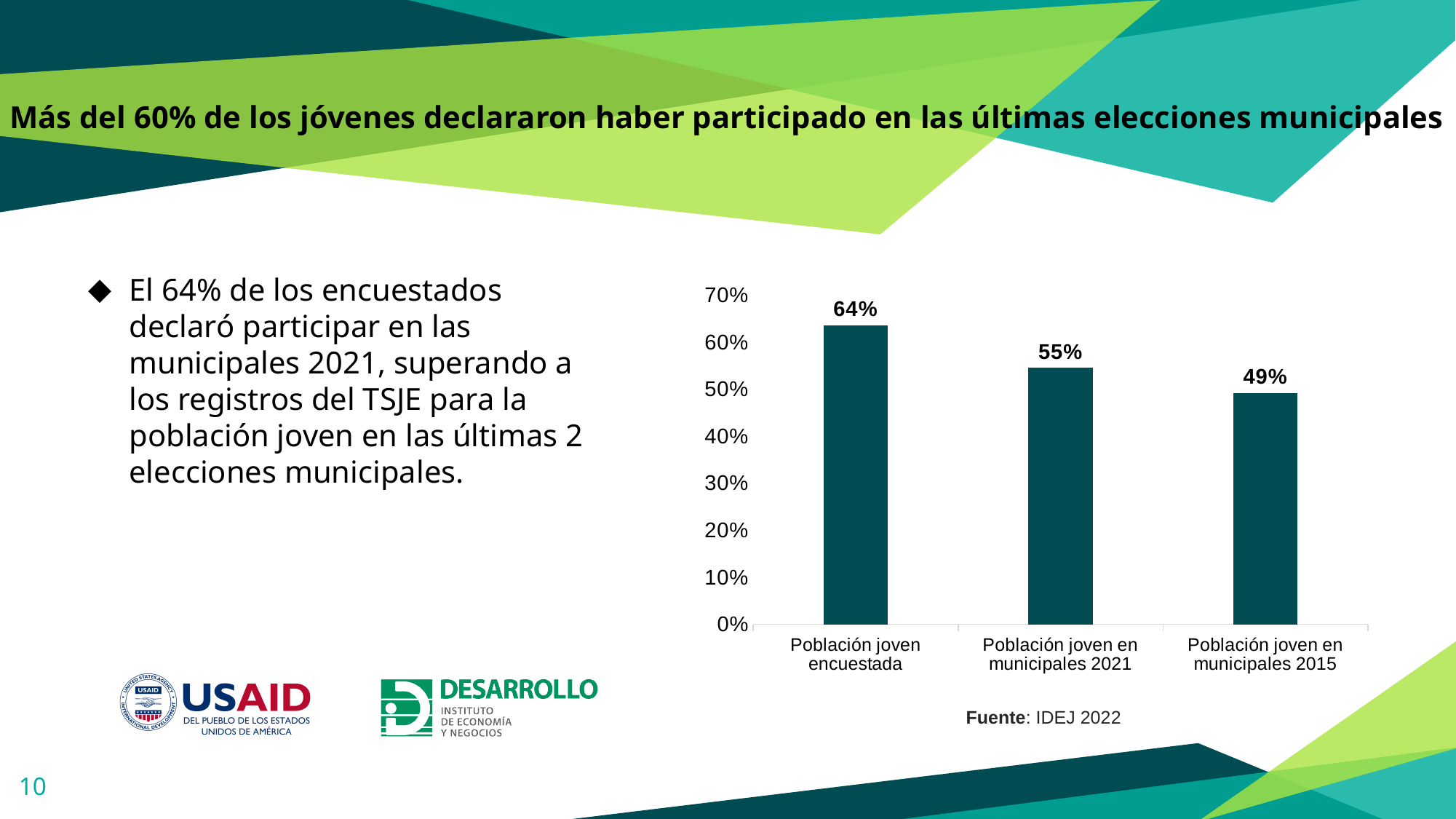
What kind of chart is shown on the slide? bar chart What is the difference between Población joven en municipales 2021 and Población joven en municipales 2015? 6% Which category has the highest value? Población joven encuestada Which is larger, Población joven en municipales 2021 or Población joven en municipales 2015? Población joven en municipales 2021 What is the value for Población joven en municipales 2015? 49% What is the value for Población joven en municipales 2021? 55% Do the values rise or fall from left to right across the categories? fall What is the difference between Población joven encuestada and Población joven en municipales 2021? 9% Is the value for Población joven en municipales 2015 greater or less than 50%? less Which category has the lowest value? Población joven en municipales 2015 How many categories are shown in the chart? 3 What is the value for Población joven encuestada? 64%